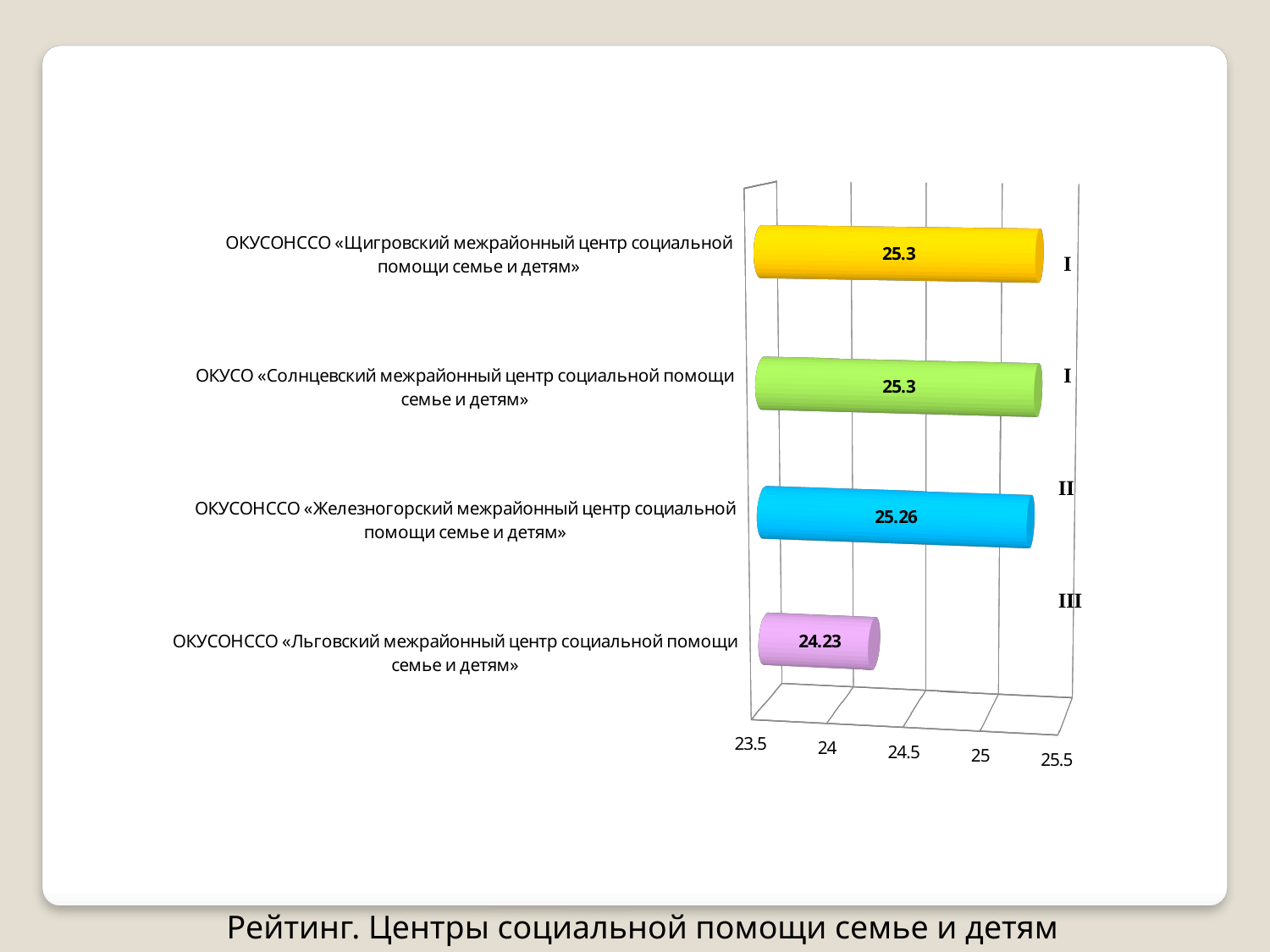
Is the value for the Льговский centre greater or less than 24.5? less What is the value for ОКУСО «Солнцевский межрайонный центр социальной помощи семье и детям»? 25.3 What is the difference between the values for the Щигровский centre and the Льговский centre? 1.07 What is the value for ОКУСОНССО «Щигровский межрайонный центр социальной помощи семье и детям»? 25.3 What is the difference between the values for the Железногорский centre and the Льговский centre? 1.03 What is the value for ОКУСОНССО «Железногорский межрайонный центр социальной помощи семье и детям»? 25.26 How many centres are shown on the chart? 4 What is the value for ОКУСОНССО «Льговский межрайонный центр социальной помощи семье и детям»? 24.23 Which has the larger value, the Железногорский centre or the Льговский centre? ОКУСОНССО «Железногорский межрайонный центр социальной помощи семье и детям» What kind of chart is shown on the slide? bar chart What is the title of the chart on the slide? Рейтинг. Центры социальной помощи семье и детям Which centre has the lowest value on the chart? ОКУСОНССО «Льговский межрайонный центр социальной помощи семье и детям»